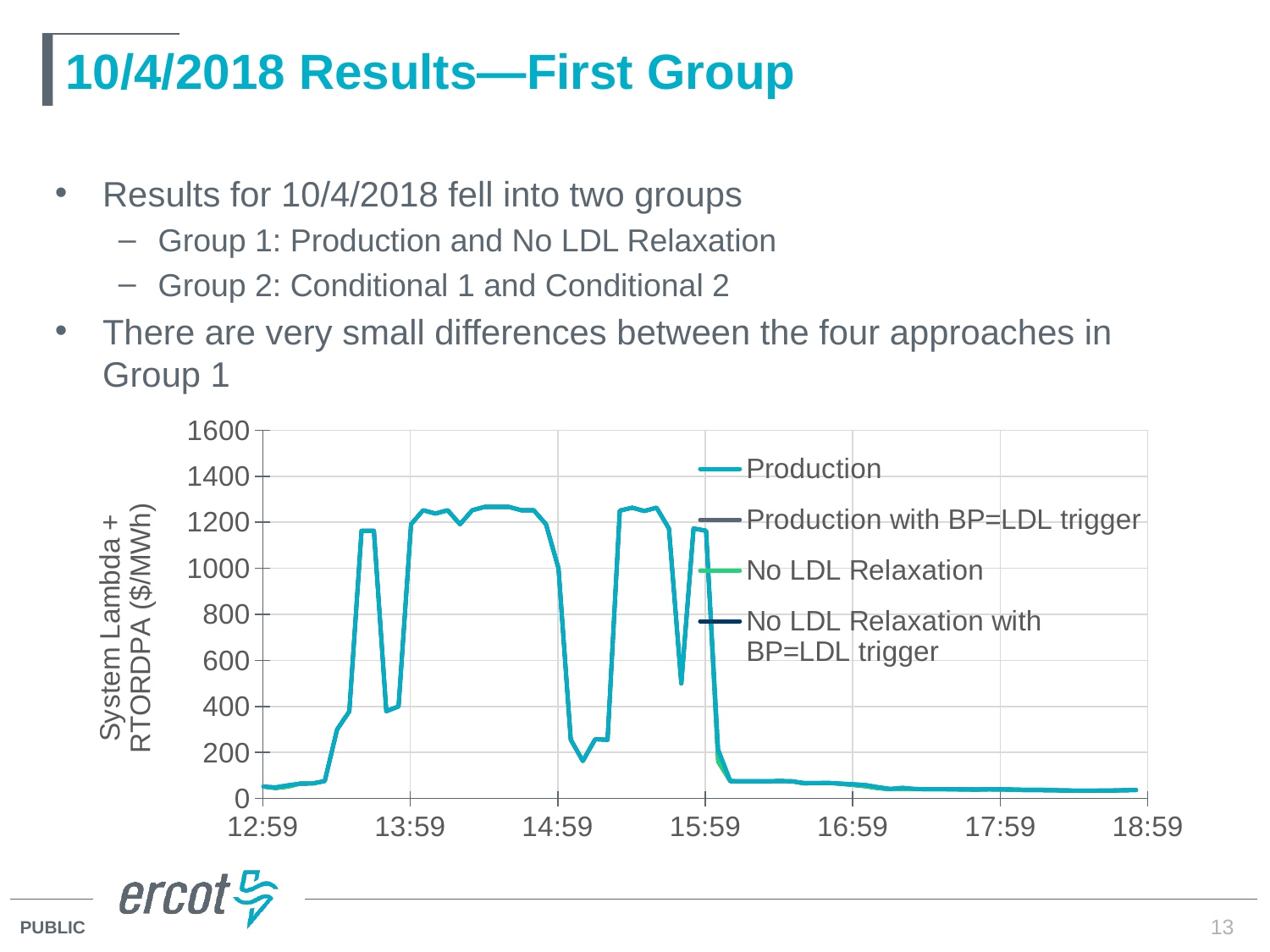
Is the value of the Production series at 16:59 greater or less than 200? less What kind of chart is shown on the slide? line chart How many series does the chart's legend list? 4 Is the value of the Production series at 18:59 greater or less than 200? less Is the highest value reached by the Production series greater or less than 1200? greater How many time labels are shown on the chart's x axis? 7 Between 15:59 and 16:59, do the values of the Production series rise or fall? fall What is the first series listed in the chart's legend? Production What is the label on the chart's vertical axis? System Lambda + RTORDPA ($/MWh)